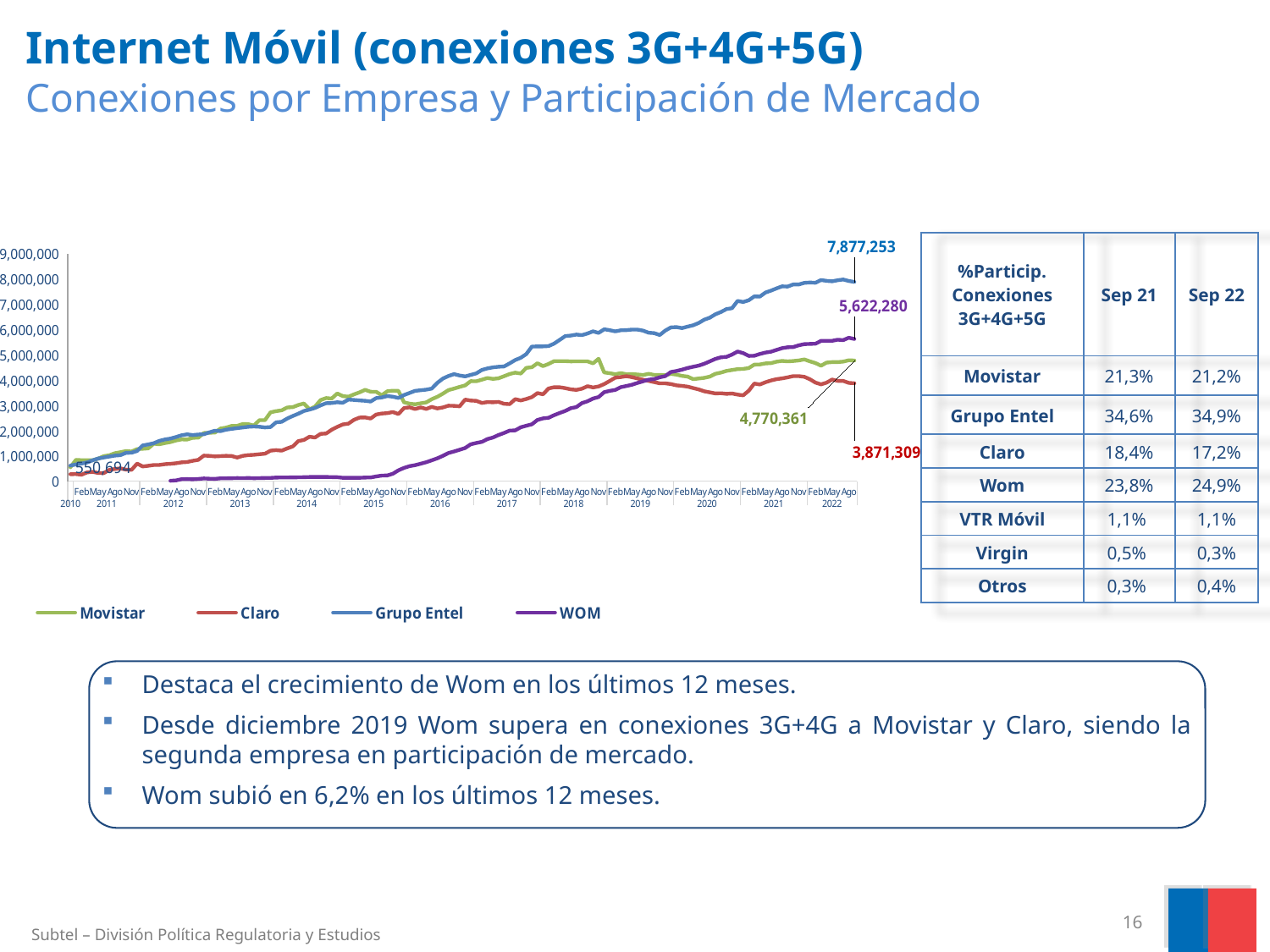
Which company has the highest number of connections at the end of the chart (2022)? Grupo Entel At the end of the chart, which has more connections, WOM or Movistar? WOM Is the value for WOM in 2015 greater or less than 1,000,000? less What is the difference between the latest labelled values of Grupo Entel and WOM? 2,254,973 Which company has the lowest number of connections at the end of the chart (2022)? Claro How many series does the chart legend list? 4 What is the latest labelled value for Claro on the chart? 3,871,309 What is the latest labelled value for Movistar on the chart? 4,770,361 What kind of chart is shown on the slide? line chart What is the latest labelled value for Grupo Entel on the chart? 7,877,253 What is the latest labelled value for WOM on the chart? 5,622,280 Does the Grupo Entel line generally rise or fall from 2010 to 2022? rise